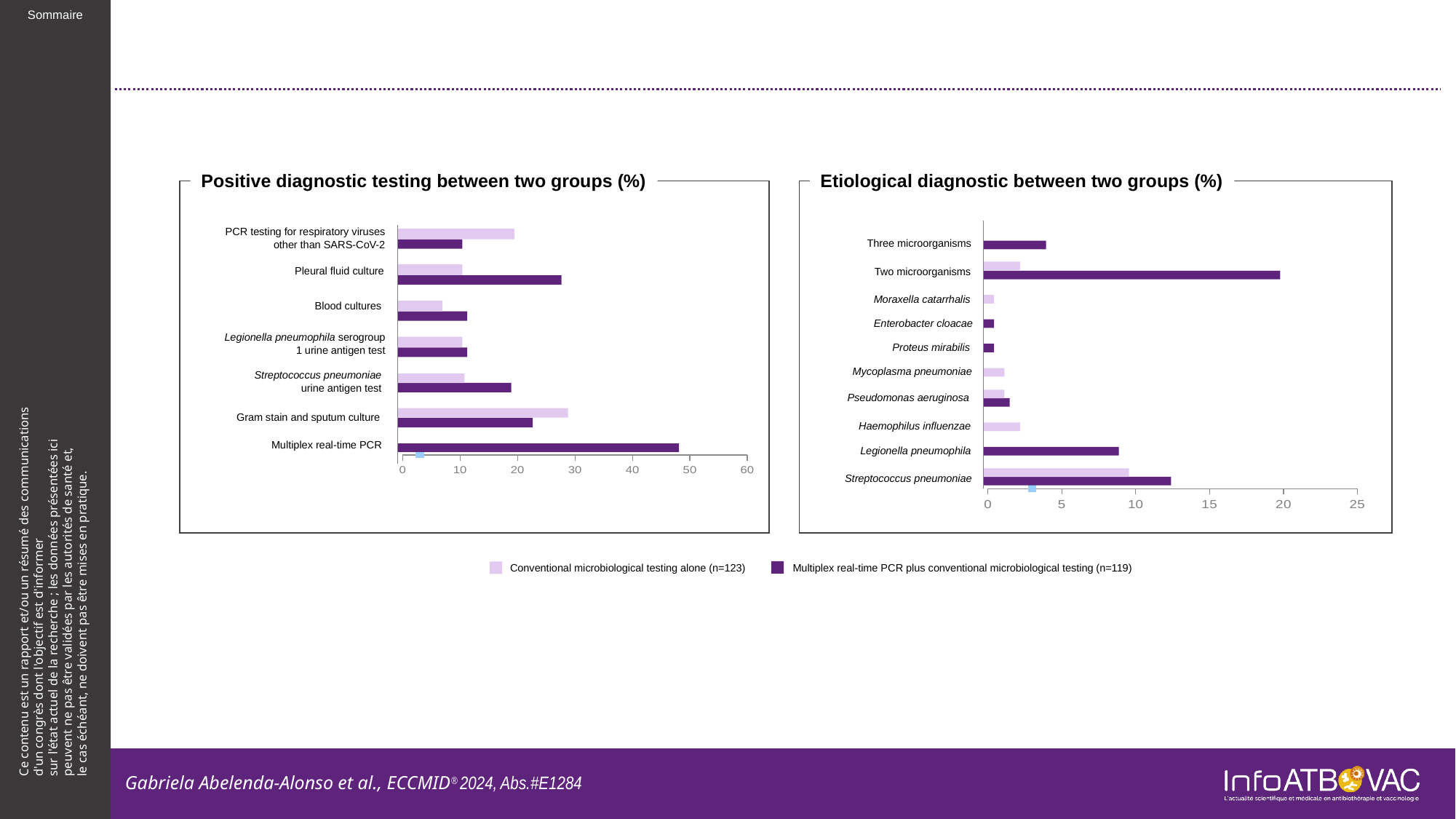
What kind of chart is the 'Positive diagnostic testing between two groups (%)' chart? bar chart In the 'Positive diagnostic testing between two groups (%)' chart, is the Conventional microbiological testing alone value for Gram stain and sputum culture greater or less than 20? greater How many categories are shown on the 'Positive diagnostic testing between two groups (%)' chart? 7 How many categories are shown on the 'Etiological diagnostic between two groups (%)' chart? 10 In the 'Etiological diagnostic between two groups (%)' chart, which category has the highest value for the Multiplex real-time PCR plus conventional microbiological testing series? Two microorganisms In the 'Positive diagnostic testing between two groups (%)' chart, which category has the highest value for the Multiplex real-time PCR plus conventional microbiological testing series? Multiplex real-time PCR In the 'Positive diagnostic testing between two groups (%)' chart, for Pleural fluid culture, which series has the larger value: Conventional microbiological testing alone or Multiplex real-time PCR plus conventional microbiological testing? Multiplex real-time PCR plus conventional microbiological testing In the 'Etiological diagnostic between two groups (%)' chart, is the Multiplex real-time PCR plus conventional testing value for Two microorganisms greater or less than 15? greater What is the title of the chart on the right side of the slide? Etiological diagnostic between two groups (%) In the 'Etiological diagnostic between two groups (%)' chart, is the Conventional microbiological testing alone value for Streptococcus pneumoniae greater or less than 5? greater How many series does the legend list for the charts? 2